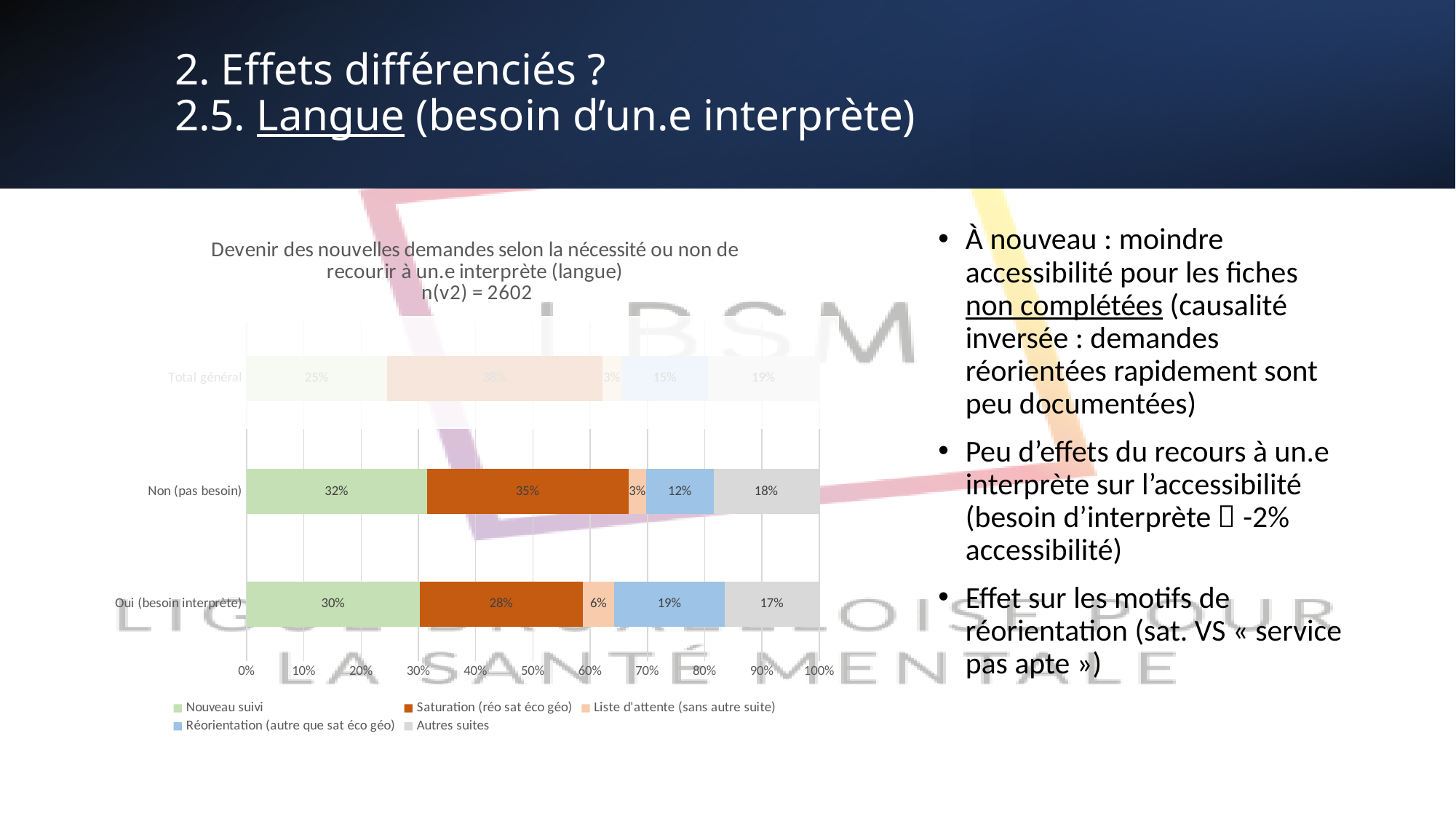
Which series has the lowest value for the category Non (pas besoin)? Liste d'attente (sans autre suite) What is the difference between the Nouveau suivi values for Non (pas besoin) and Oui (besoin interprète)? 2% What is the value of Autres suites for the category Oui (besoin interprète)? 17% What is the difference between the Réorientation (autre que sat éco géo) values for Oui (besoin interprète) and Non (pas besoin)? 7% What is the value of Réorientation (autre que sat éco géo) for the category Non (pas besoin)? 12% How many series does the legend list? 5 What is the value of Saturation (réo sat éco géo) for the category Oui (besoin interprète)? 28% What is the value of Nouveau suivi for the category Non (pas besoin)? 32% What sample size n(v2) is stated in the chart title? 2602 Which category has the higher value for Saturation (réo sat éco géo): Non (pas besoin) or Oui (besoin interprète)? Non (pas besoin) What kind of chart is shown on the slide? Stacked bar chart What is the value of Liste d'attente (sans autre suite) for the category Oui (besoin interprète)? 6%